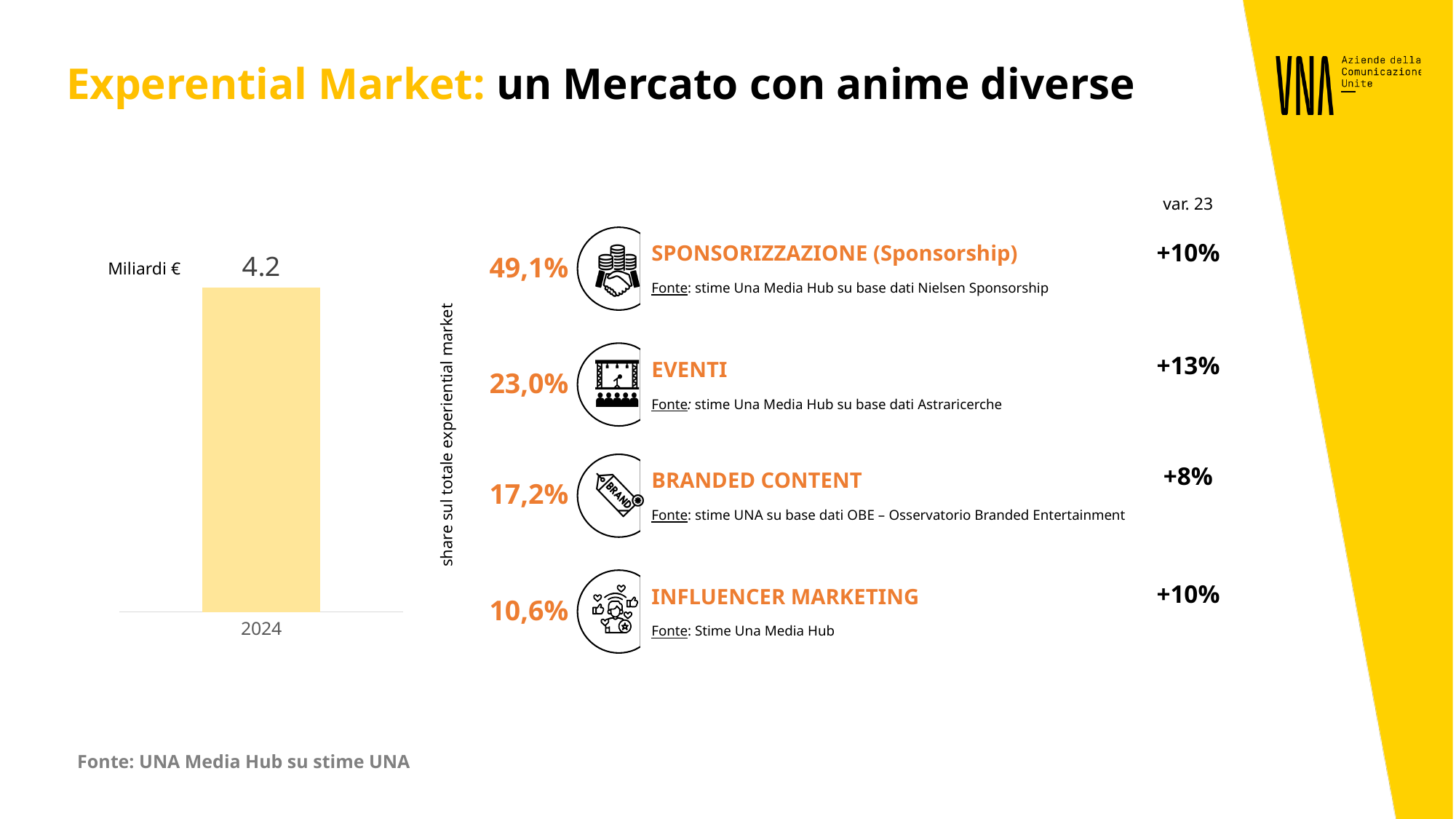
What unit is indicated next to the bar chart on the left? Miliardi € In the share breakdown on the right, what is the share for INFLUENCER MARKETING? 10,6% In the share breakdown on the right, which segment has the largest var. 23 value? EVENTI In the share breakdown on the right, what is the var. 23 value for BRANDED CONTENT? +8% How many bars does the bar chart on the left show? 1 In the bar chart on the left, what is the value for 2024? 4.2 In the share breakdown on the right, what is the share for EVENTI? 23,0% In the share breakdown on the right, which segment has the highest share of the experiential market? SPONSORIZZAZIONE (Sponsorship) In the share breakdown on the right, what is the share for SPONSORIZZAZIONE (Sponsorship)? 49,1% What kind of chart is shown on the left of the slide? bar chart In the share breakdown on the right, which segment has the lowest share of the experiential market? INFLUENCER MARKETING What is the category label on the x axis of the bar chart on the left? 2024